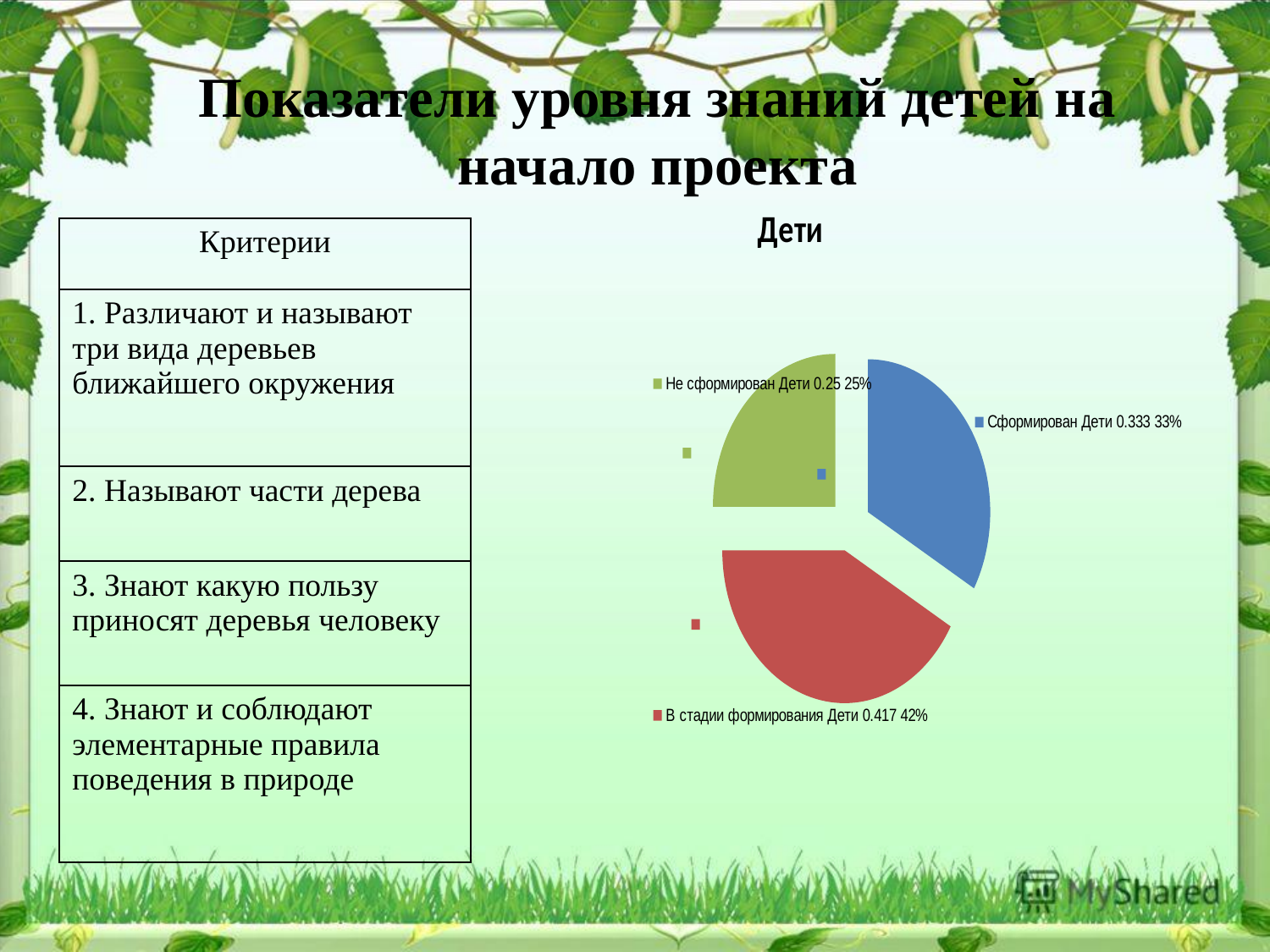
What percentage is shown for the slice 'Не сформирован'? 25% How many slices does the pie chart have? 3 What is the difference in percentage points between 'В стадии формирования' and 'Не сформирован'? 17 What colour is the slice for 'Сформирован'? blue What type of chart is shown on the slide? pie chart What percentage is shown for the slice 'Сформирован'? 33% Which slice of the pie chart is the largest? В стадии формирования What value is printed for 'В стадии формирования' before the percentage? 0.417 Which is larger: the share for 'Сформирован' or for 'Не сформирован'? Сформирован What percentage is shown for the slice 'В стадии формирования'? 42% What is the title of the chart? Дети Which slice of the pie chart is the smallest? Не сформирован